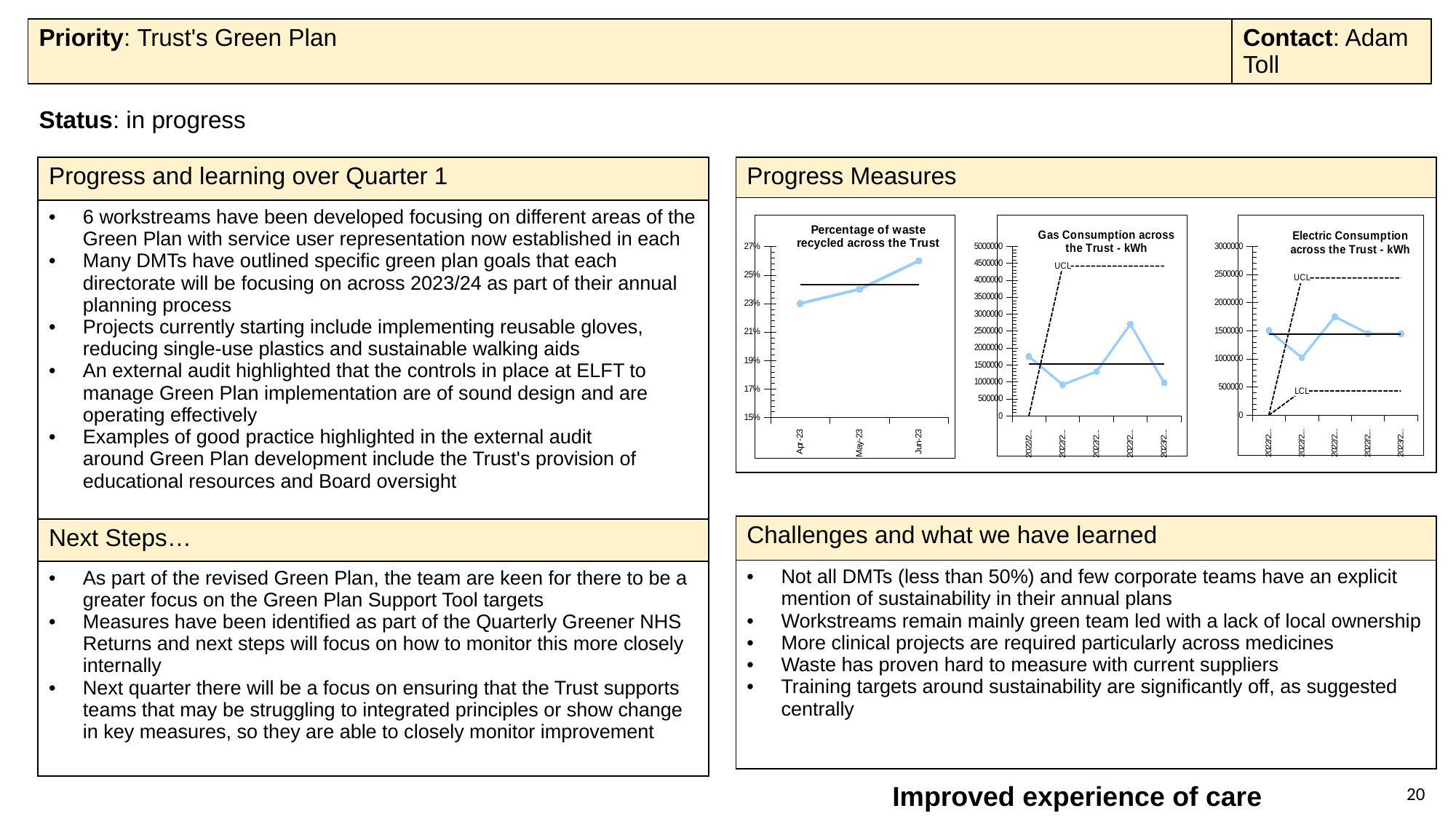
On the 'Electric Consumption across the Trust - kWh' chart, is the lowest plotted value greater or less than 1500000? less Which two control limit labels are shown on the 'Electric Consumption across the Trust - kWh' chart? UCL and LCL On the 'Percentage of waste recycled across the Trust' chart, is the value for Apr-23 greater or less than 25%? less How many months are plotted on the 'Percentage of waste recycled across the Trust' chart? 3 On the 'Percentage of waste recycled across the Trust' chart, which month has the highest value? Jun-23 On the 'Gas Consumption across the Trust - kWh' chart, is the highest plotted value greater or less than 2500000? greater How many data points are plotted on the 'Gas Consumption across the Trust - kWh' chart? 5 On the 'Percentage of waste recycled across the Trust' chart, do the values rise or fall from Apr-23 to Jun-23? rise What kind of chart is the 'Percentage of waste recycled across the Trust' chart? line chart On the 'Percentage of waste recycled across the Trust' chart, which month has the lowest value? Apr-23